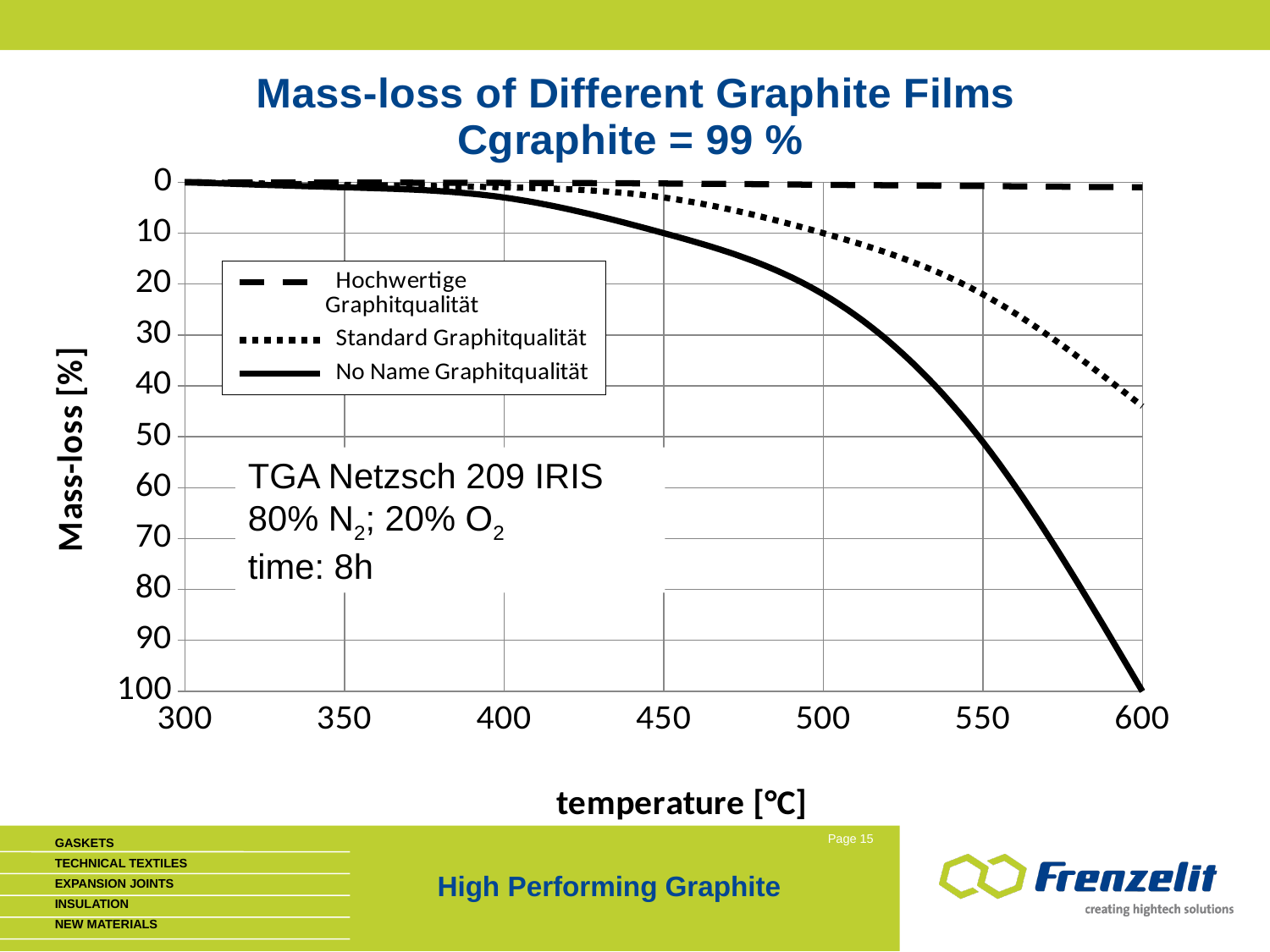
Which series shows the highest mass-loss at 600 °C? No Name Graphitqualität Which series shows the lowest mass-loss at 600 °C? Hochwertige Graphitqualität Is the mass-loss of No Name Graphitqualität at 500 °C greater or less than 10? greater What kind of chart is shown on the slide? line chart Is the mass-loss of Hochwertige Graphitqualität at 600 °C greater or less than 10? less At 550 °C, which series has the larger mass-loss, Standard Graphitqualität or No Name Graphitqualität? No Name Graphitqualität Is the mass-loss of No Name Graphitqualität at 600 °C greater or less than 90? greater How many series does the legend list? 3 Does the mass-loss of No Name Graphitqualität rise or fall as temperature increases along the x axis? rise What is the title of the chart? Mass-loss of Different Graphite Films Cgraphite = 99 % What is the label of the vertical axis? Mass-loss [%]